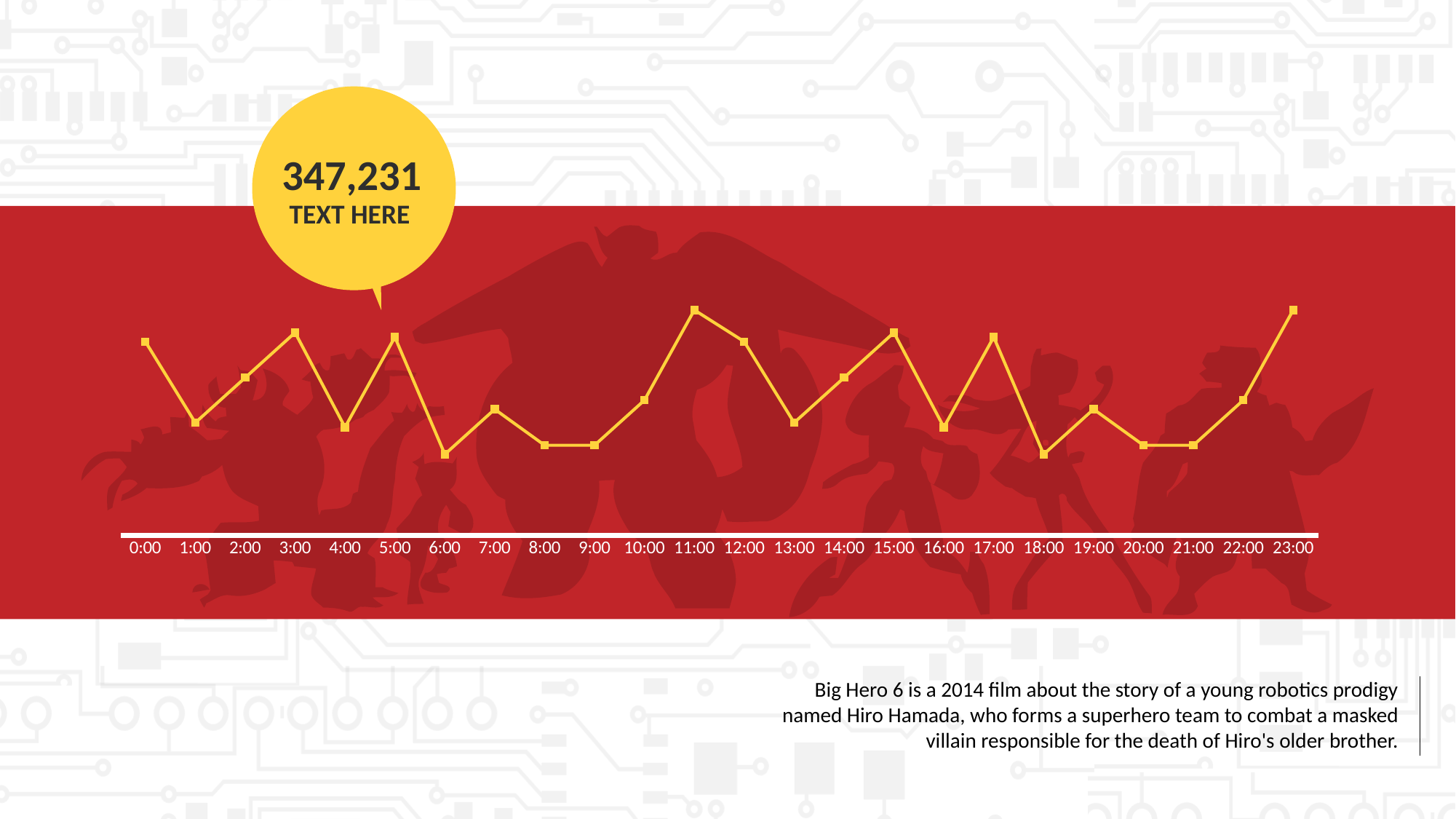
Does the line rise or fall from 21:00 to 23:00? rise What is the last time label on the x axis? 23:00 What is the first time label on the x axis? 0:00 Which is higher on the chart, the value at 11:00 or the value at 8:00? 11:00 Which is higher on the chart, the value at 3:00 or the value at 1:00? 3:00 Does the line rise or fall from 13:00 to 15:00? rise Which is higher on the chart, the value at 17:00 or the value at 20:00? 17:00 Does the line rise or fall from 11:00 to 13:00? fall What kind of chart is shown on the slide? line chart How many time points are labelled along the x axis of the chart? 24